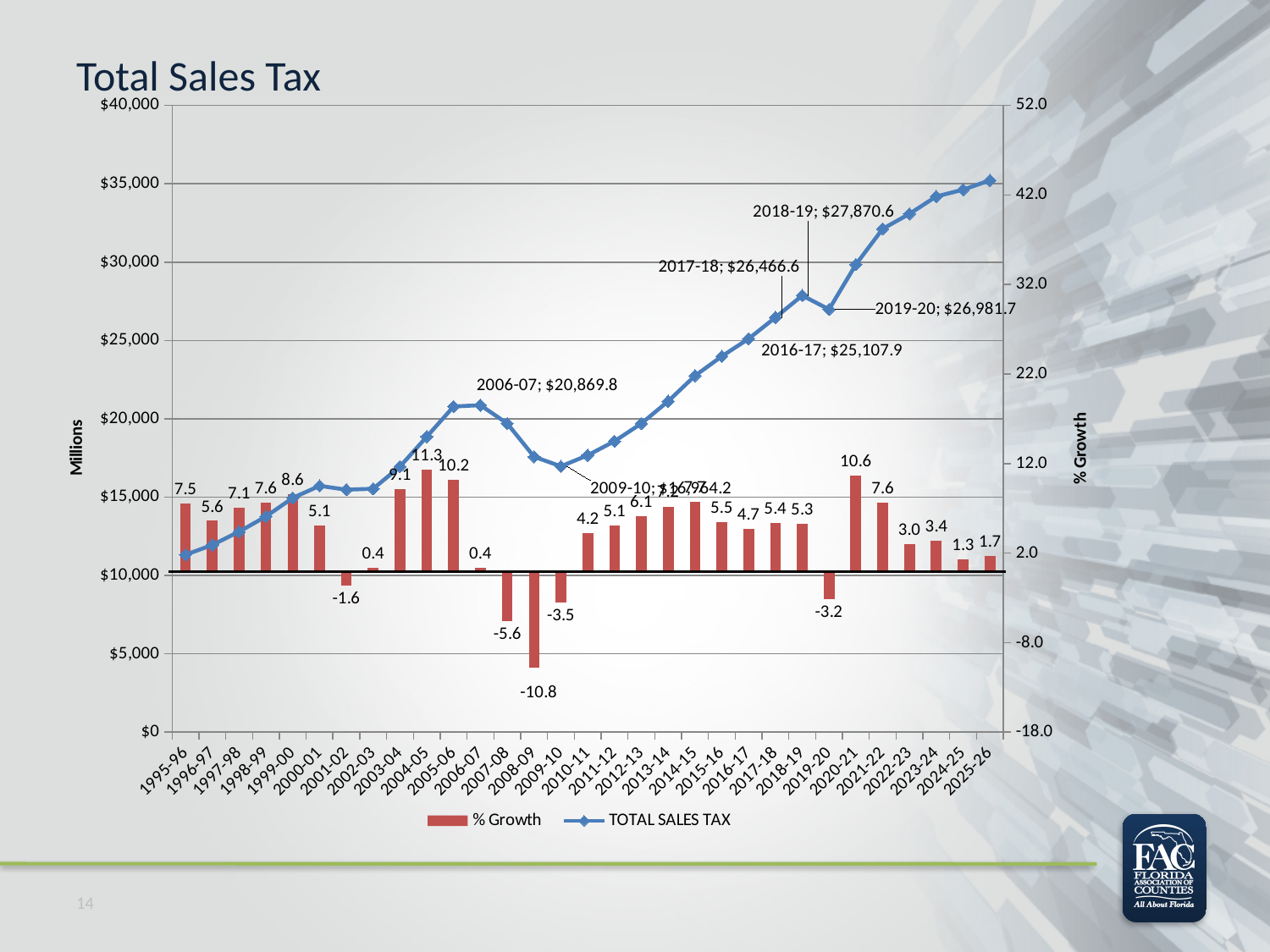
What is the TOTAL SALES TAX value labelled for 2016-17? $25,107.9 What is the TOTAL SALES TAX value labelled for 2018-19? $27,870.6 Which year has the highest % Growth? 2004-05 What are the two entries in the legend? % Growth and TOTAL SALES TAX What is the difference between the TOTAL SALES TAX values for 2018-19 and 2017-18? $1,404.0 What is the % Growth value for 2008-09? -10.8 What kind of chart is shown on the slide? A combination bar and line chart Is the TOTAL SALES TAX value for 2025-26 greater or less than $30,000? greater Which year has the larger % Growth, 2020-21 or 2021-22? 2020-21 How many fiscal years are shown on the x axis? 31 How many series does the legend list? 2 Which year has the lowest % Growth? 2008-09